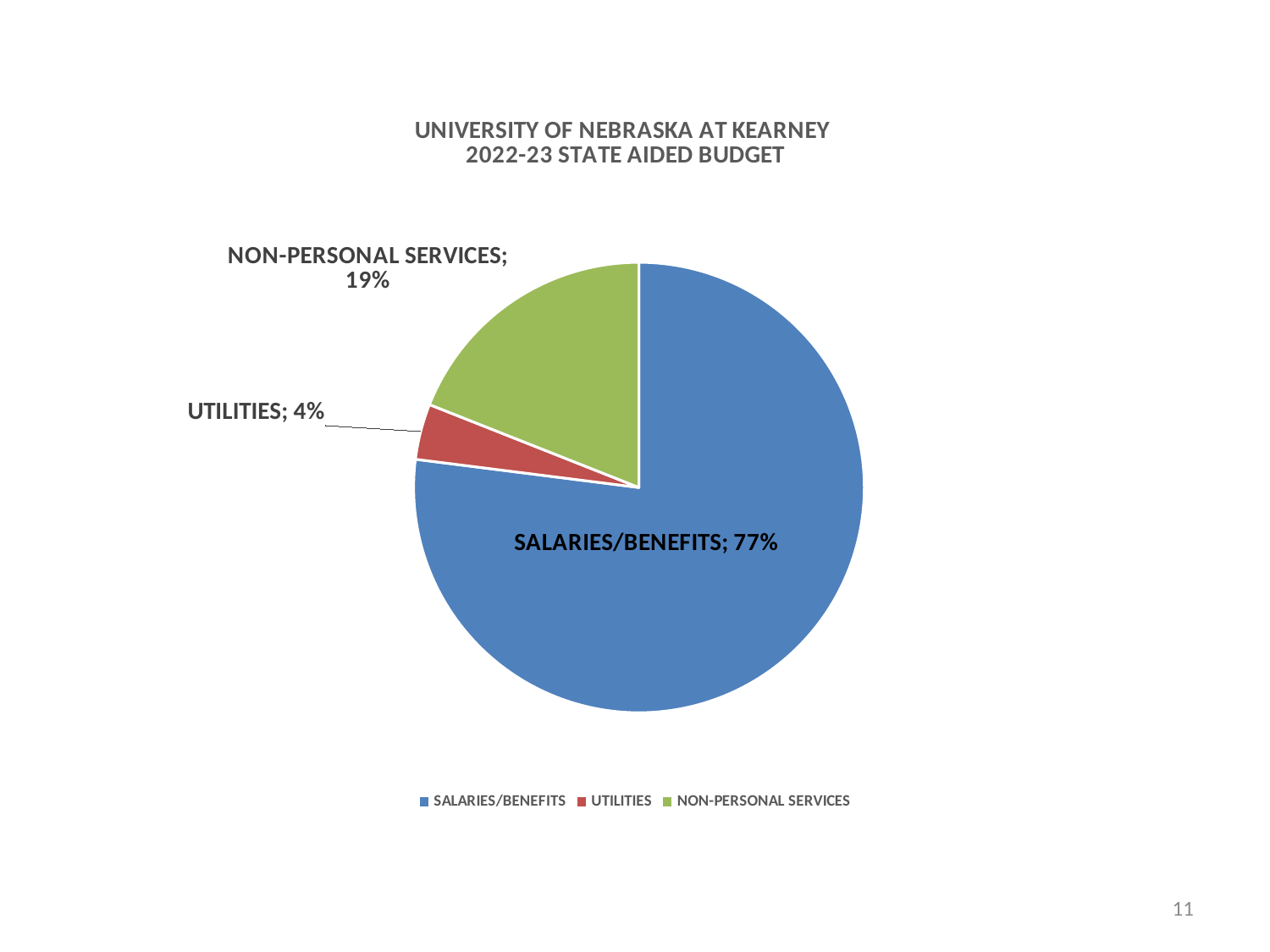
What is the difference in percentage points between Non-Personal Services and Utilities? 15 What colour represents Utilities in the pie chart? Red Which is larger, the share for Utilities or the share for Non-Personal Services? Non-Personal Services Which category has the smallest share of the budget? Utilities Which category has the largest share of the budget? Salaries/Benefits What share of the budget goes to Utilities? 4% What is the title of the chart? University of Nebraska at Kearney 2022-23 State Aided Budget What share of the budget goes to Non-Personal Services? 19% What share of the budget goes to Salaries/Benefits? 77% How many categories are shown in the pie chart? 3 What kind of chart is shown on the slide? Pie chart What is the difference in percentage points between Salaries/Benefits and Non-Personal Services? 58